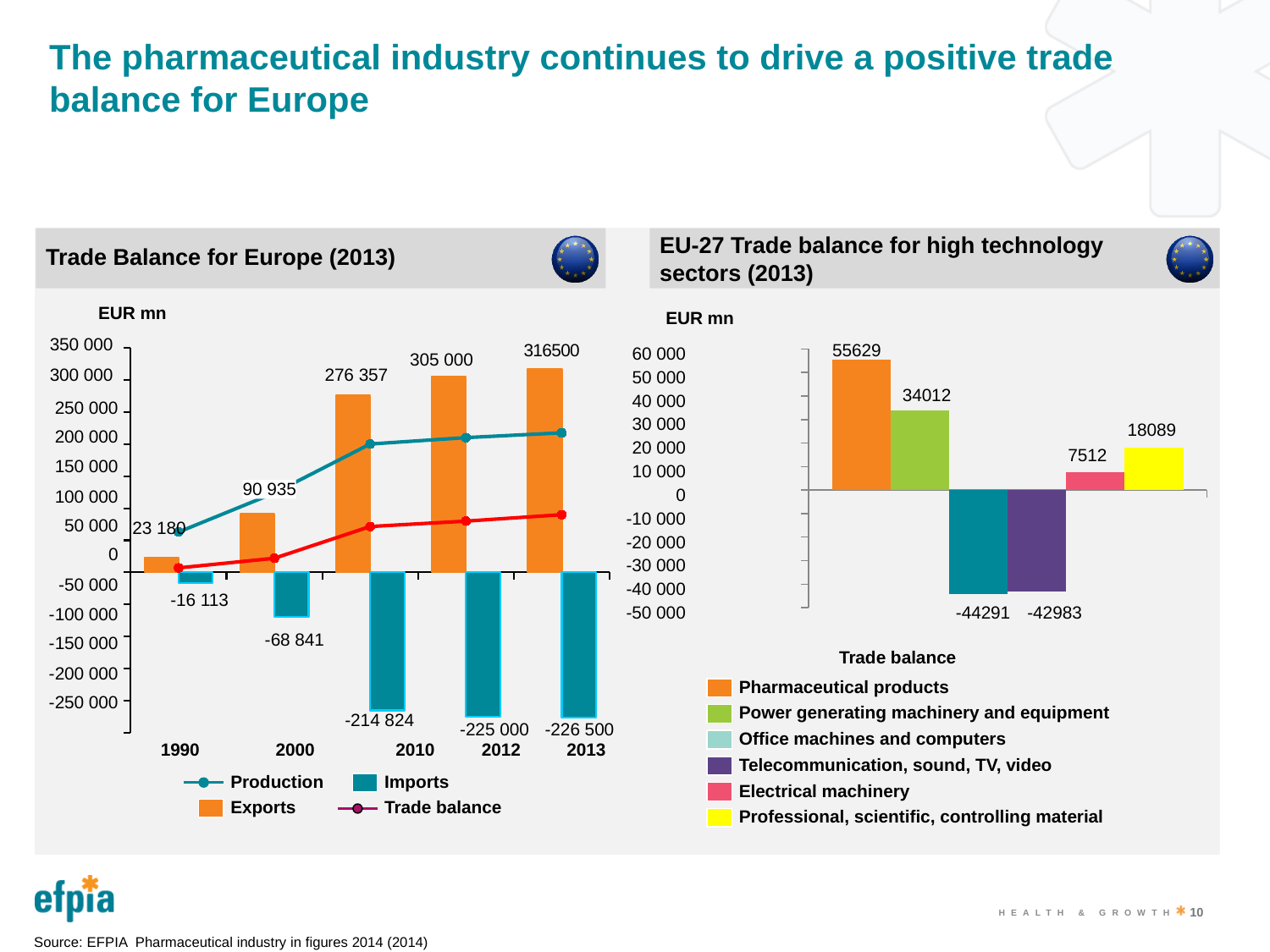
In the 'Trade Balance for Europe (2013)' chart, how many years are shown on the x axis? 5 In the 'Trade Balance for Europe (2013)' chart, how many series does the legend list? 4 In the 'EU-27 Trade balance for high technology sectors (2013)' chart, what is the trade balance for Pharmaceutical products? 55629 In the 'EU-27 Trade balance for high technology sectors (2013)' chart, how much larger is the trade balance for Pharmaceutical products than for Power generating machinery and equipment? 21617 In the 'Trade Balance for Europe (2013)' chart, by how much did Exports increase from 2012 to 2013? 11 500 In the 'EU-27 Trade balance for high technology sectors (2013)' chart, which sector has the highest trade balance? Pharmaceutical products In the 'EU-27 Trade balance for high technology sectors (2013)' chart, how many sectors does the legend list? 6 In the 'Trade Balance for Europe (2013)' chart, what is the value of Exports in 1990? 23 180 In the 'Trade Balance for Europe (2013)' chart, do Exports rise or fall from 1990 to 2013? rise In the 'Trade Balance for Europe (2013)' chart, what is the value of Imports in 2010? -214 824 In the 'Trade Balance for Europe (2013)' chart, what is the value of Exports in 2013? 316500 In the 'EU-27 Trade balance for high technology sectors (2013)' chart, what is the trade balance for Telecommunication, sound, TV, video? -42983